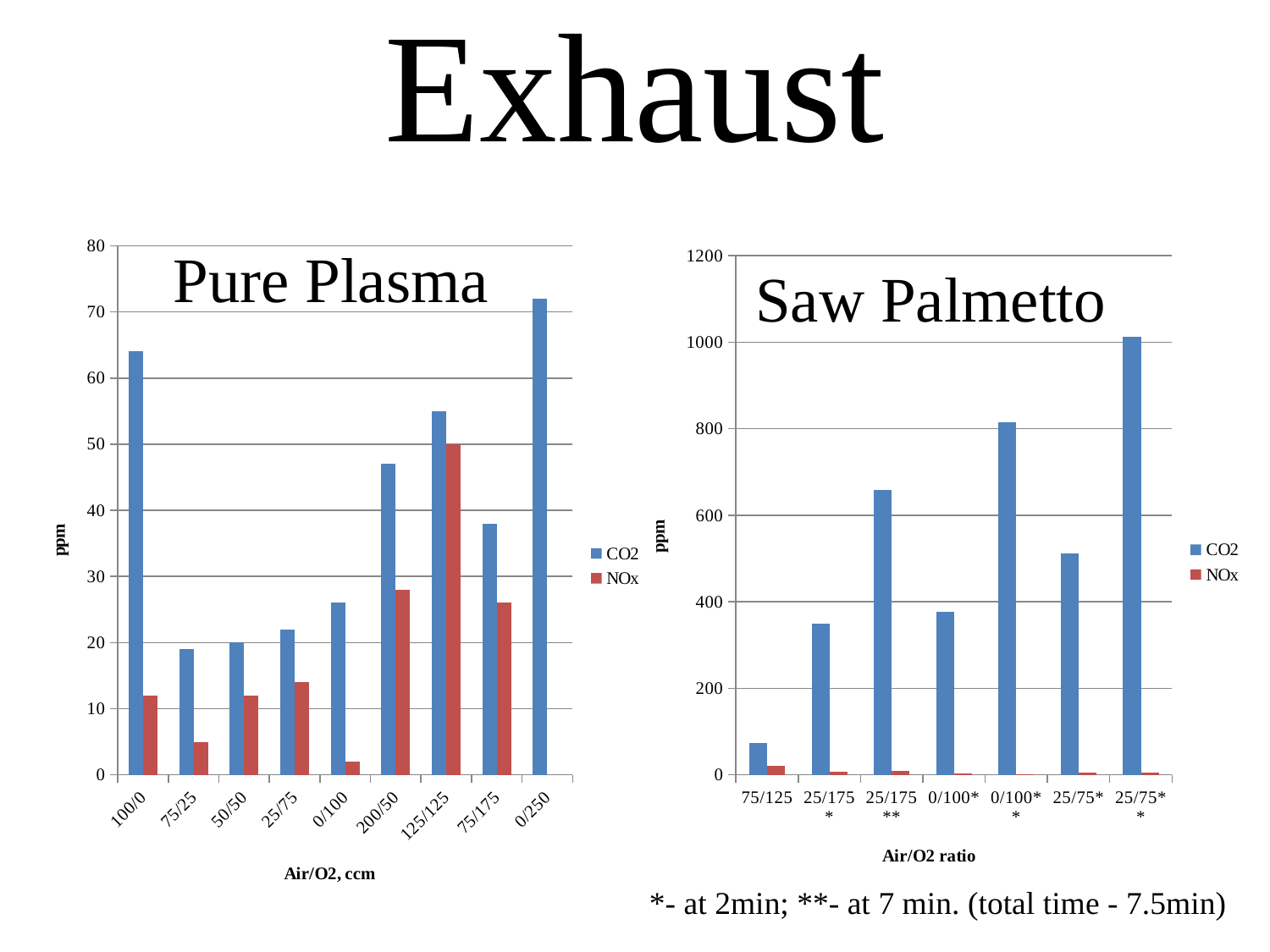
In the Saw Palmetto chart, is the CO2 value for 25/175** greater or less than 600? greater In the Pure Plasma chart, which Air/O2 category has the highest NOx value? 125/125 How many Air/O2 categories are shown on the x axis of the Pure Plasma chart? 9 In the Saw Palmetto chart, which category has the highest CO2 value? 25/75** How many series does the legend of the Pure Plasma chart list? 2 How many Air/O2 ratio categories are shown on the x axis of the Saw Palmetto chart? 7 What kind of chart is the Pure Plasma chart? bar chart In the Pure Plasma chart, which Air/O2 category has the highest CO2 value? 0/250 In the Saw Palmetto chart, which category has the lowest CO2 value? 75/125 What is the x-axis title of the Pure Plasma chart? Air/O2, ccm In the Pure Plasma chart, is the CO2 value for 100/0 greater or less than 60? greater In the Pure Plasma chart, which is larger for 200/50: CO2 or NOx? CO2